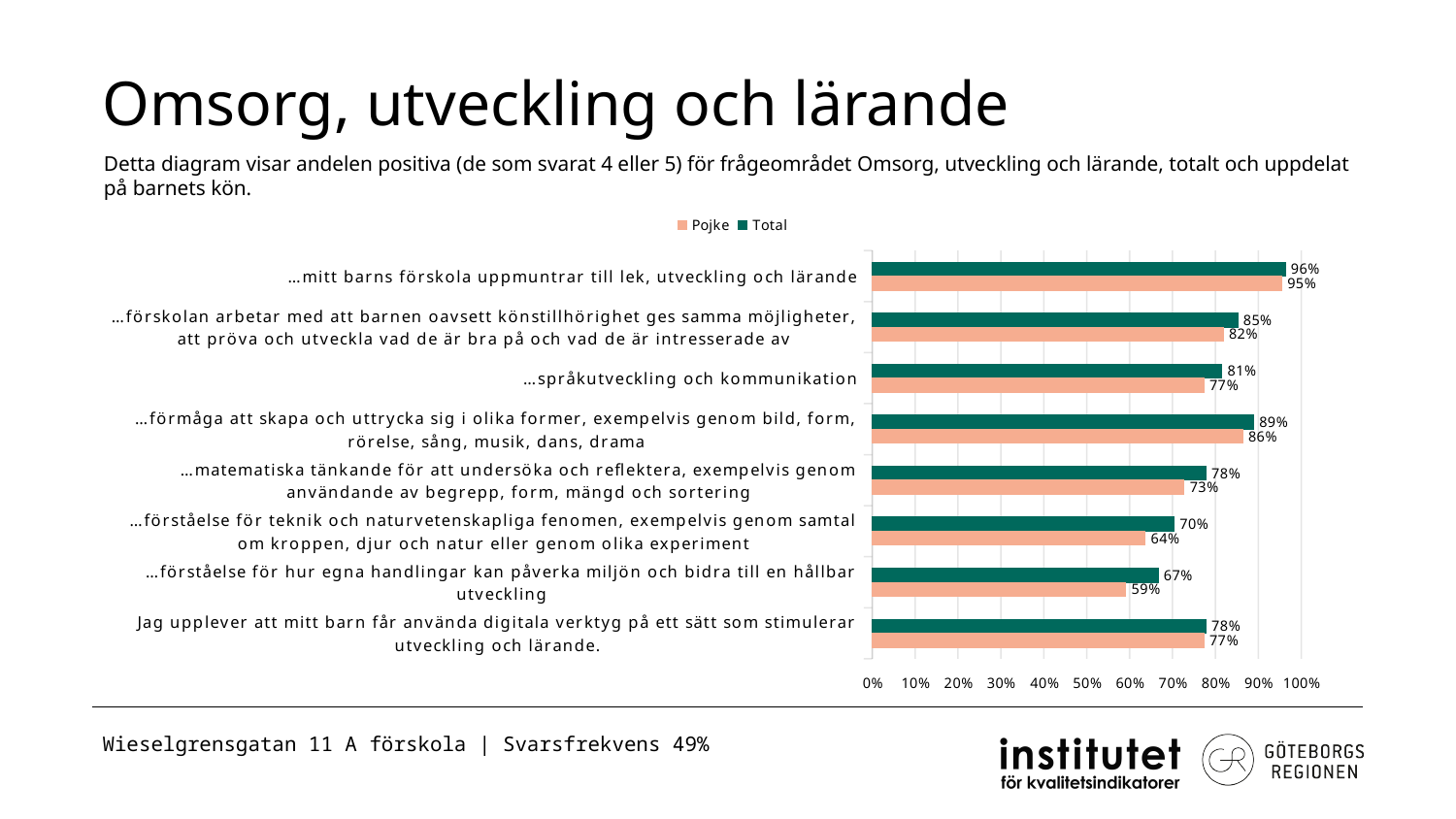
Is the Pojke value for "…förmåga att skapa och uttrycka sig i olika former, exempelvis genom bild, form, rörelse, sång, musik, dans, drama" greater or less than 80%? greater How many categories are shown in the chart? 8 What kind of chart is shown on the slide? Bar chart What is the difference between the Total and Pojke values for "…förståelse för teknik och naturvetenskapliga fenomen, exempelvis genom samtal om kroppen, djur och natur eller genom olika experiment"? 6 percentage points How many series does the legend list? 2 Which series is shown in dark green in the chart? Total What is the Pojke value for "…förståelse för hur egna handlingar kan påverka miljön och bidra till en hållbar utveckling"? 59% Which category has the highest Total value? …mitt barns förskola uppmuntrar till lek, utveckling och lärande What is the Total value for "…språkutveckling och kommunikation"? 81% Which is larger for "…matematiska tänkande för att undersöka och reflektera, exempelvis genom användande av begrepp, form, mängd och sortering": the Total value or the Pojke value? Total Which category has the lowest Pojke value? …förståelse för hur egna handlingar kan påverka miljön och bidra till en hållbar utveckling What is the Pojke value for "…mitt barns förskola uppmuntrar till lek, utveckling och lärande"? 95%